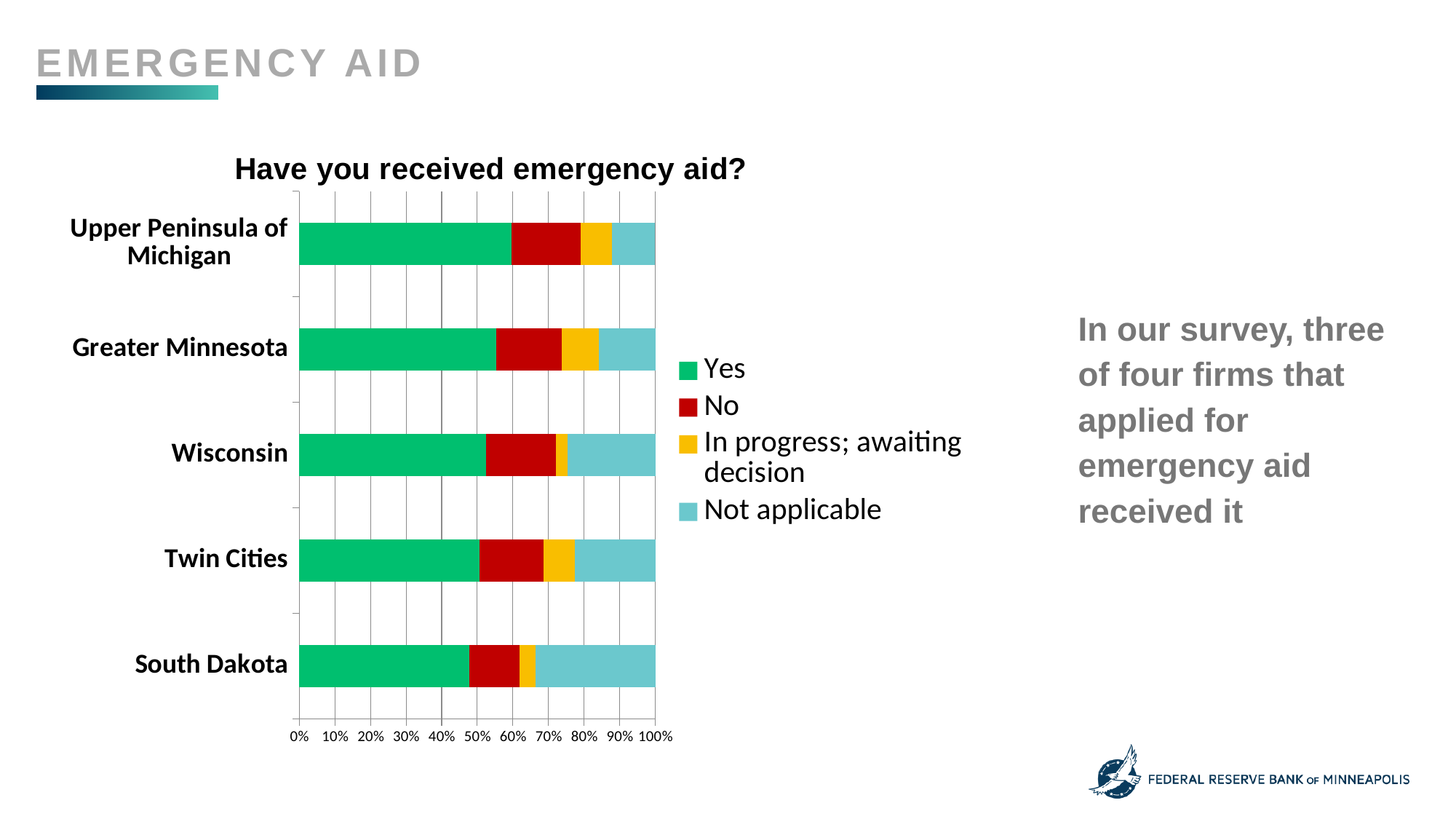
Which region has the largest 'Yes' share? Upper Peninsula of Michigan What is the title of the chart? Have you received emergency aid? Which region has a larger 'Yes' share, Upper Peninsula of Michigan or South Dakota? Upper Peninsula of Michigan How many series does the legend list? 4 Which region has the largest 'Not applicable' share? South Dakota Is the 'Yes' share for South Dakota greater or less than 60%? less How many regions are shown on the chart? 5 Which region has the smallest 'Yes' share? South Dakota Which colour represents the 'Not applicable' response in the chart? Light blue Which region has a larger 'In progress; awaiting decision' share, Greater Minnesota or Wisconsin? Greater Minnesota What kind of chart is shown on the slide? Bar chart Is the 'Yes' share for Upper Peninsula of Michigan greater or less than 50%? greater